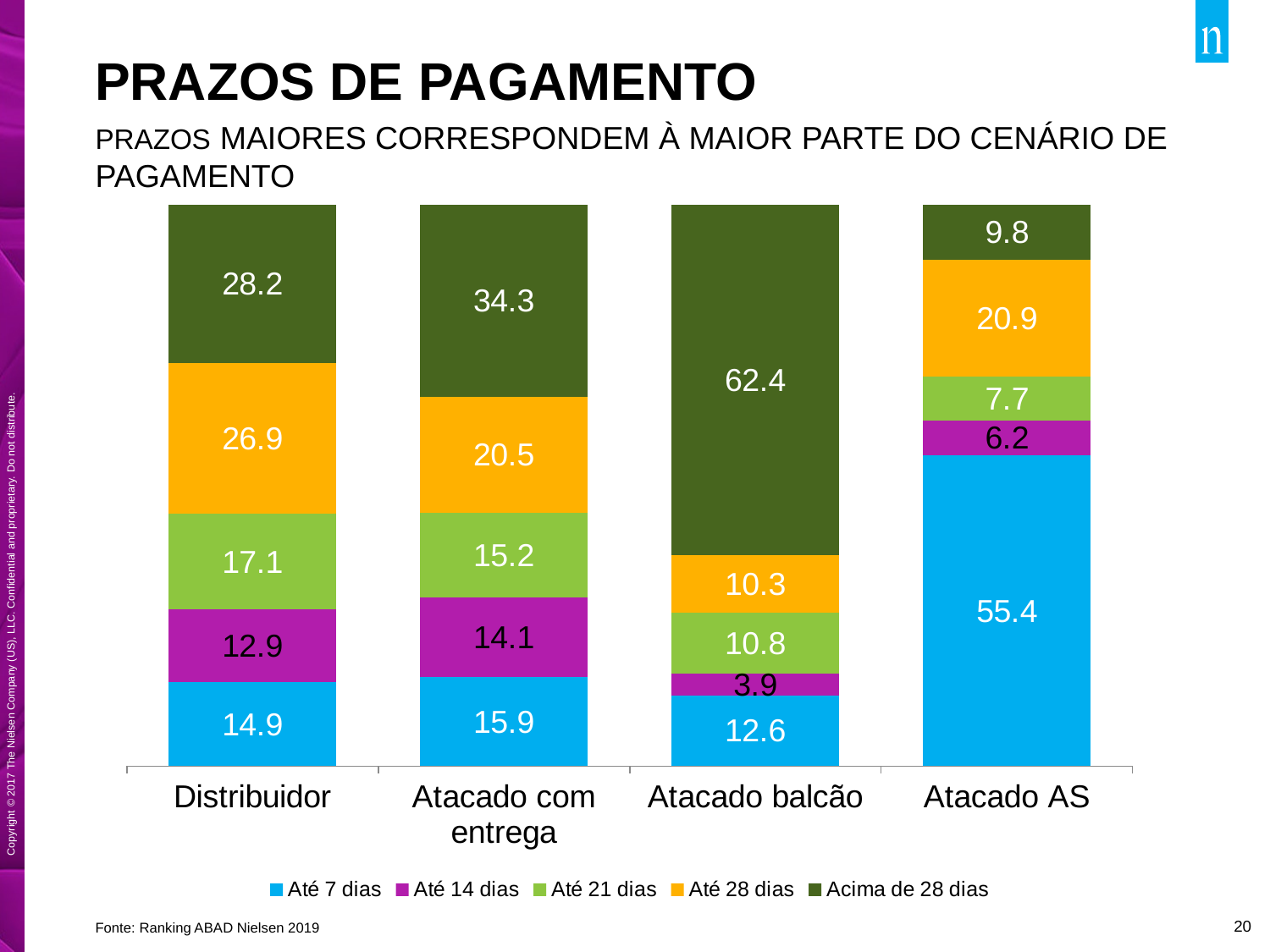
What is the difference between the 'Acima de 28 dias' values for Atacado com entrega and Distribuidor? 6.1 What is the value for 'Até 28 dias' in the Distribuidor bar? 26.9 What is the value for 'Até 7 dias' in the Atacado AS bar? 55.4 What is the value for 'Acima de 28 dias' in the Atacado balcão bar? 62.4 Which is larger: the 'Até 21 dias' value for Distribuidor or for Atacado com entrega? Distribuidor Which category has the highest value for 'Acima de 28 dias'? Atacado balcão How many series does the legend list? 5 What is the total of the stacked bar for Atacado AS? 100.0 Which legend entry is shown in blue? Até 7 dias How many categories are shown on the x axis? 4 What type of chart is shown on the slide? Stacked bar chart Which category has the lowest value for 'Até 14 dias'? Atacado balcão